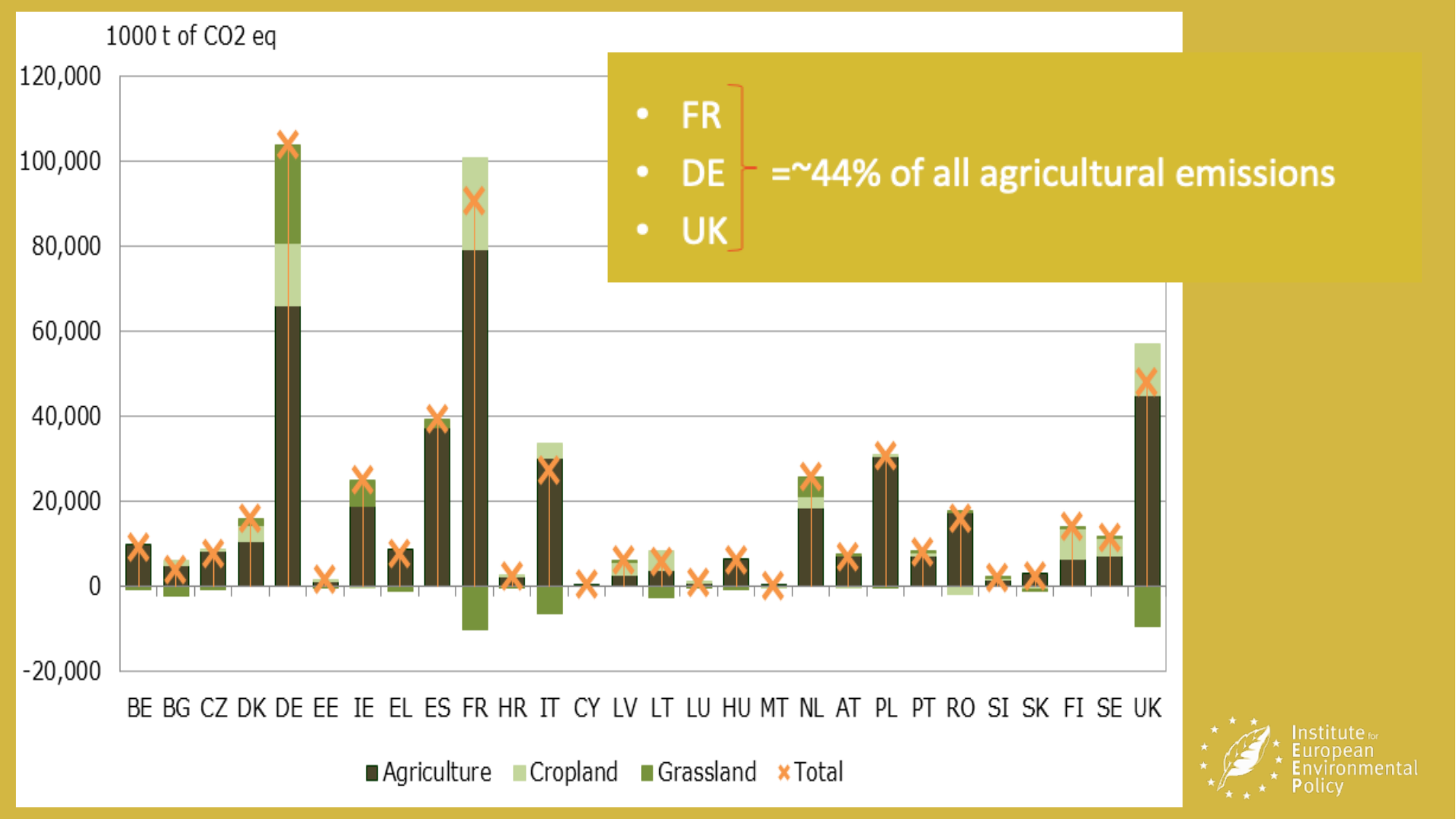
Which has the larger Total value, UK or ES? UK Is the Total value for FR greater or less than 100,000? less Is the Total value for PL greater or less than 20,000? greater Which country has the highest Total value? DE Which has the larger Total value, DE or FR? DE What unit is given for the y axis? 1000 t of CO2 eq Is the Total value for UK greater or less than 40,000? greater Which country has the highest Agriculture value? FR How many countries are shown on the x axis? 28 What kind of chart is shown on the slide? Stacked bar chart with a line/marker series for Total How many series does the legend list? 4